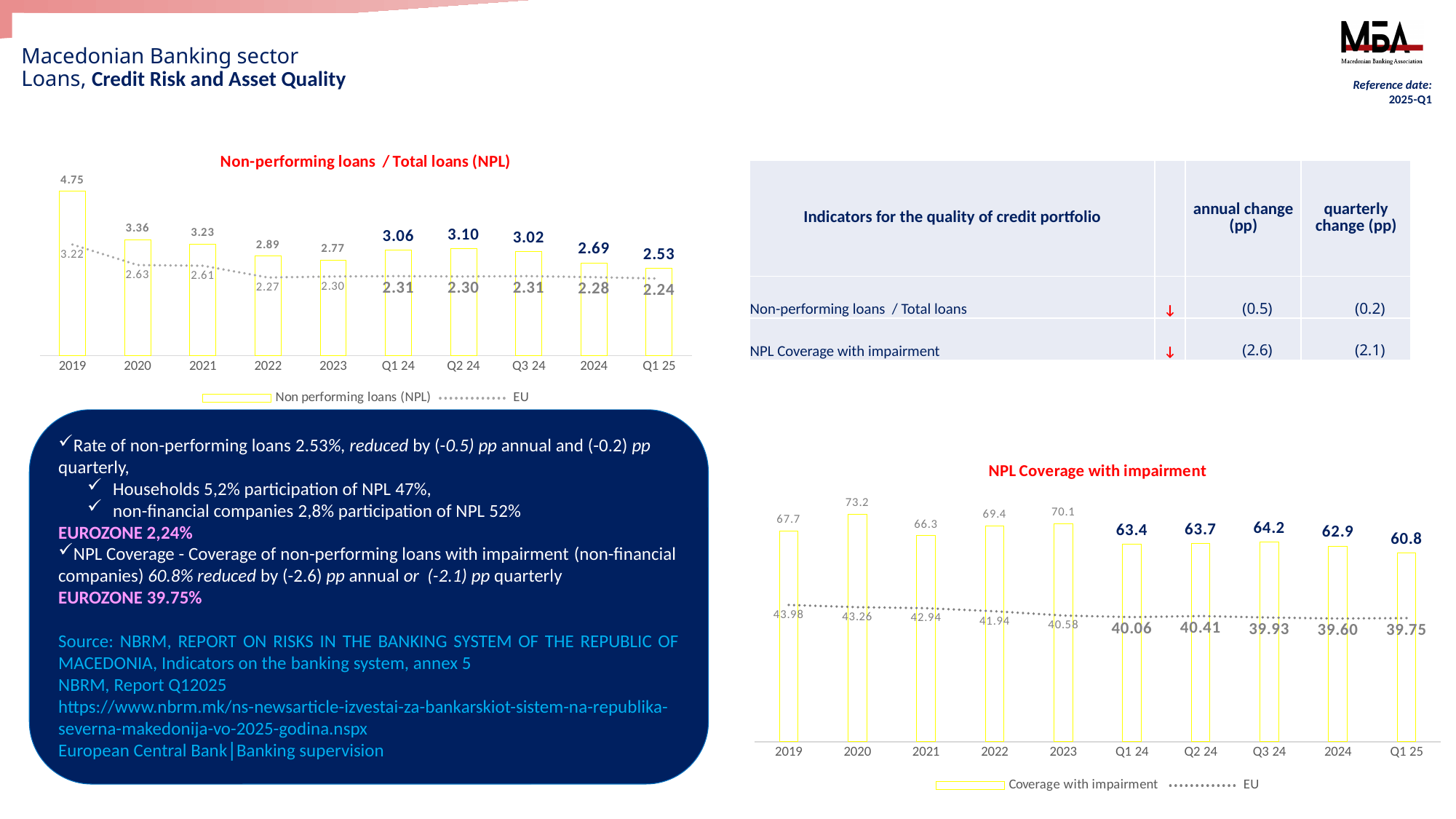
In the 'Non-performing loans / Total loans (NPL)' chart, how many series does the legend list? 2 In the 'Non-performing loans / Total loans (NPL)' chart, which period has the highest NPL bar? 2019 In the 'NPL Coverage with impairment' chart, which is larger, the coverage value for Q3 24 or for 2024? Q3 24 In the 'Non-performing loans / Total loans (NPL)' chart, what is the NPL value for Q1 25? 2.53 In the 'NPL Coverage with impairment' chart, which period has the lowest coverage bar? Q1 25 In the 'NPL Coverage with impairment' chart, what is the coverage value for 2020? 73.2 In the 'Non-performing loans / Total loans (NPL)' chart, what is the difference between the NPL value for 2019 and for 2020? 1.39 In the 'NPL Coverage with impairment' chart, what is the difference between the coverage value for 2024 and for Q1 25? 2.1 In the 'Non-performing loans / Total loans (NPL)' chart, what is the EU value for 2019? 3.22 In the 'NPL Coverage with impairment' chart, what is the EU value for Q1 25? 39.75 What kind of chart is the 'NPL Coverage with impairment' chart? Bar chart with a line In the 'Non-performing loans / Total loans (NPL)' chart, how many periods are shown on the x axis? 10